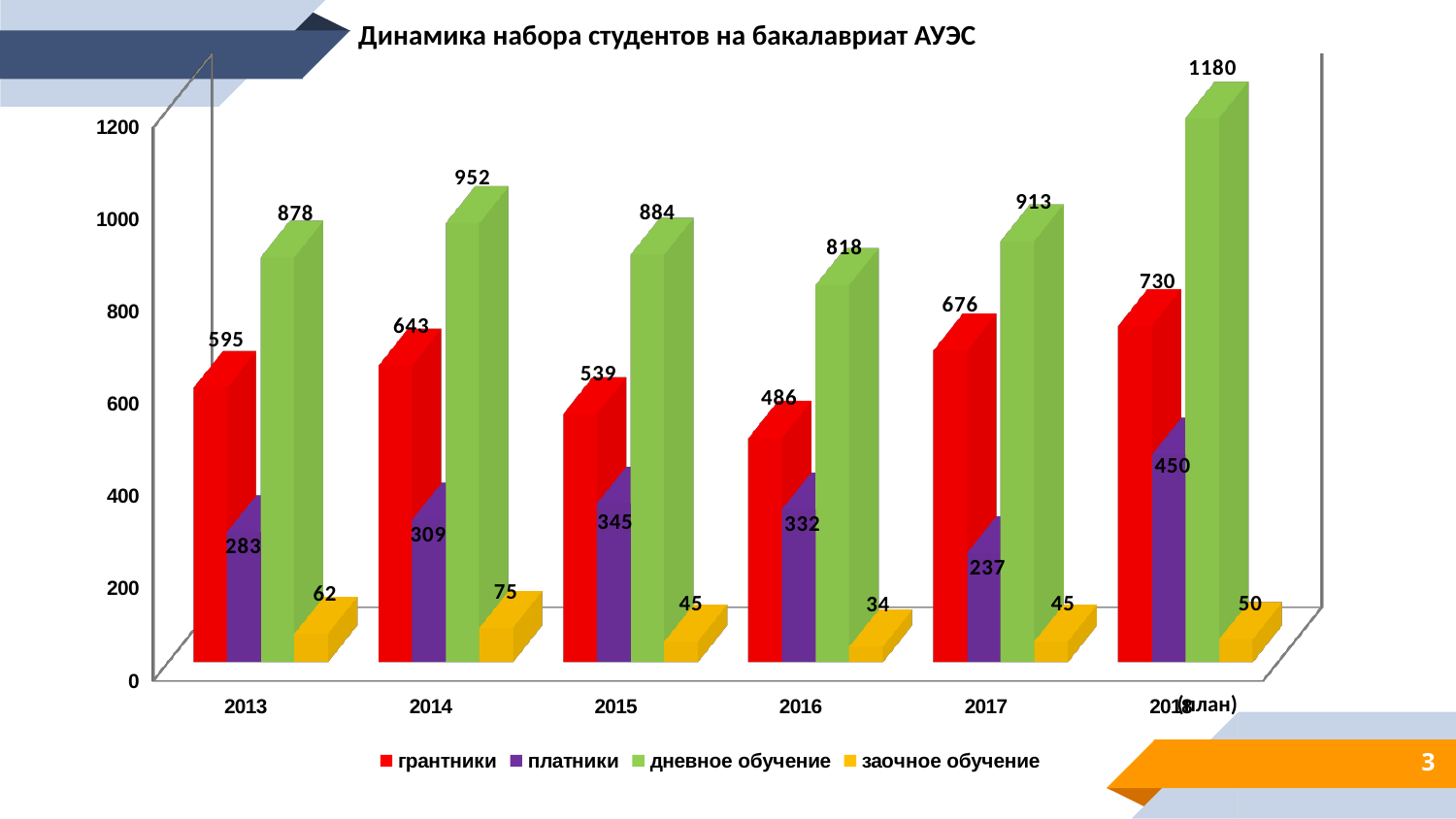
What is the value for дневное обучение in 2016? 818 What is the title of the chart? Динамика набора студентов на бакалавриат АУЭС How many series does the legend list? 4 What is the value for грантники in 2014? 643 What is the value for заочное обучение in 2013? 62 What is the value for платники in 2017? 237 What is the difference between the грантники values for 2018 (план) and 2017? 54 What kind of chart is shown on the slide? bar chart In which year is the value for заочное обучение the lowest? 2016 In which year is the value for дневное обучение the highest? 2018 (план) How many years are shown on the x axis? 6 Which is larger: платники in 2015 or платники in 2016? платники in 2015